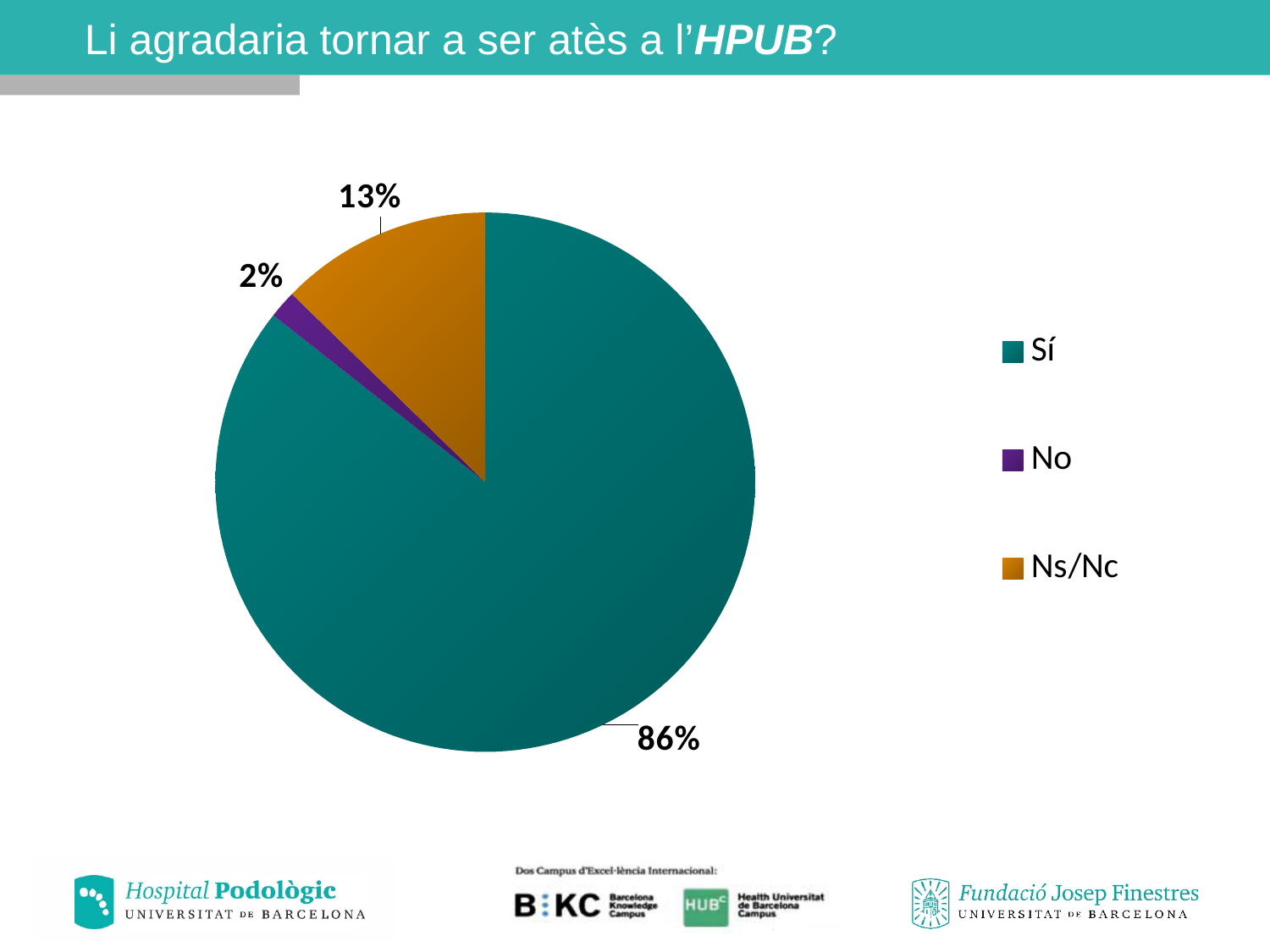
Which category has the largest share of the pie? Sí Which category has the smallest share of the pie? No What is the difference in percentage points between the "Sí" and "Ns/Nc" slices? 73 Which is larger, the "Ns/Nc" slice or the "No" slice? Ns/Nc How many entries does the legend list? 3 What percentage of respondents answered "Sí"? 86% What percentage of respondents answered "Ns/Nc"? 13% What percentage of respondents answered "No"? 2% What is the difference in percentage points between the "Ns/Nc" and "No" slices? 11 What type of chart is shown on the slide? pie chart What colour is the "Sí" slice in the pie chart? teal How many categories does the pie chart have? 3